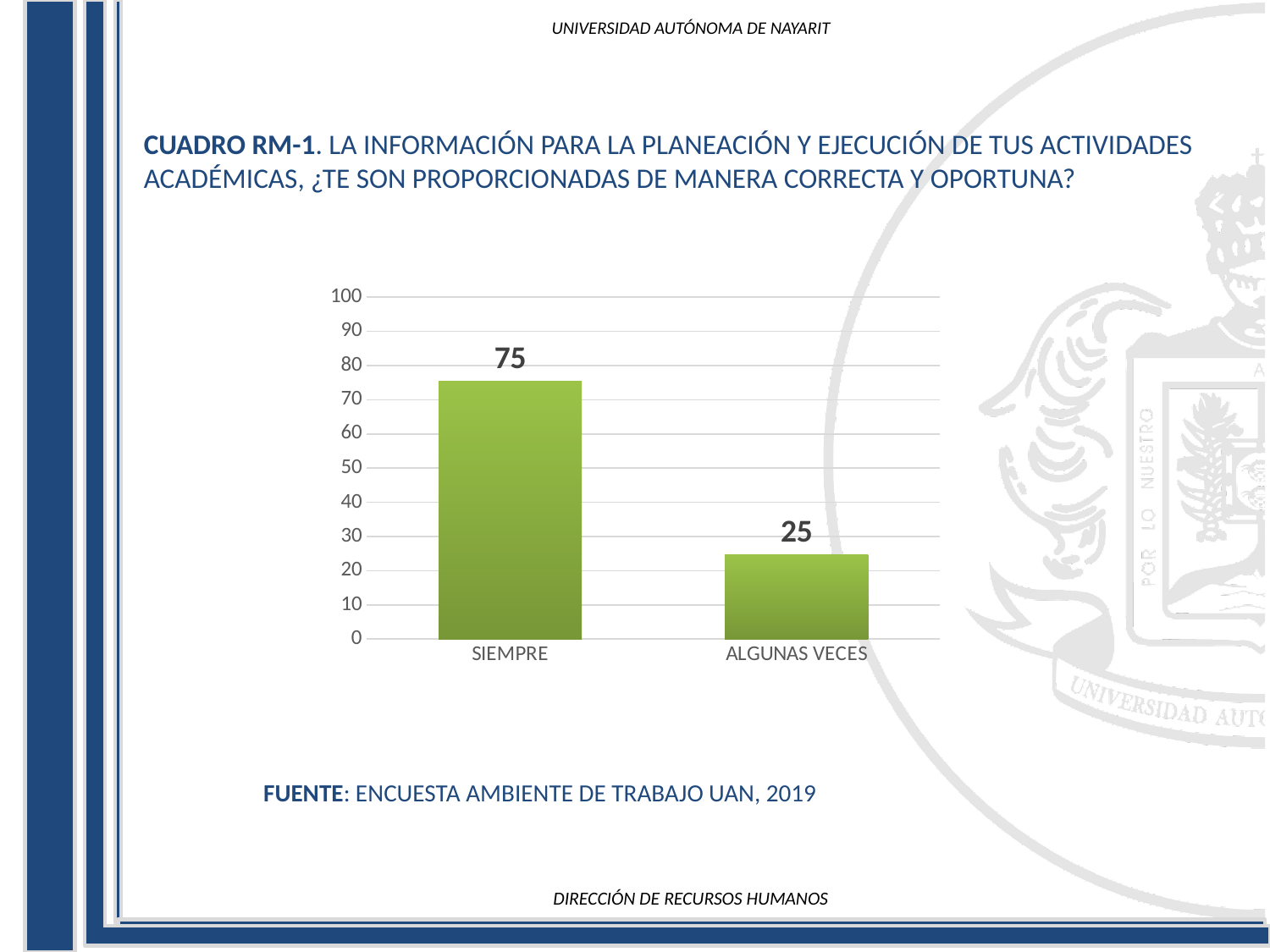
How many categories are shown on the x axis? 2 What is the difference between the values for SIEMPRE and ALGUNAS VECES? 50 What is the value for ALGUNAS VECES? 25 What source is cited below the chart? ENCUESTA AMBIENTE DE TRABAJO UAN, 2019 Is the value for SIEMPRE greater or less than 70? greater What is the value for SIEMPRE? 75 Which category has the highest value? SIEMPRE Which is larger, the value for SIEMPRE or the value for ALGUNAS VECES? SIEMPRE What is the highest value shown on the vertical axis? 100 What kind of chart is shown on the slide? bar chart Which category has the lowest value? ALGUNAS VECES Is the value for ALGUNAS VECES greater or less than 30? less